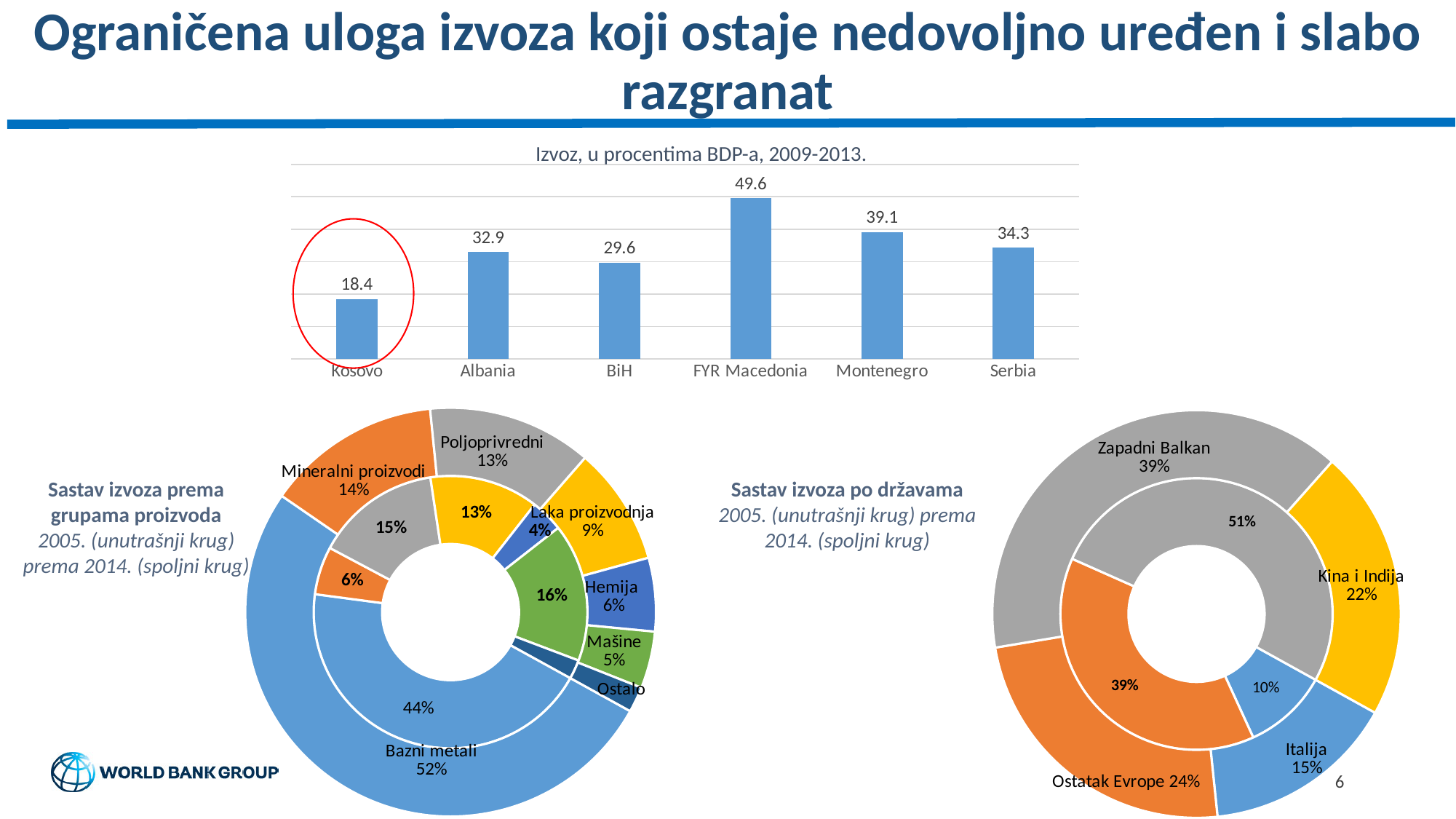
In the doughnut chart 'Sastav izvoza prema grupama proizvoda', what share does Bazni metali have in the outer (2014) ring? 52% What is the title of the bar chart at the top of the slide? Izvoz, u procentima BDP-a, 2009-2013. In the bar chart 'Izvoz, u procentima BDP-a, 2009-2013.', what is the difference between the values for FYR Macedonia and Kosovo? 31.2 In the bar chart 'Izvoz, u procentima BDP-a, 2009-2013.', which country has the lowest value? Kosovo What kind of chart is the top chart 'Izvoz, u procentima BDP-a, 2009-2013.'? bar chart In the doughnut chart 'Sastav izvoza prema grupama proizvoda', what share does Mineralni proizvodi have in the outer (2014) ring? 14% In the bar chart 'Izvoz, u procentima BDP-a, 2009-2013.', how many countries are shown? 6 In the doughnut chart 'Sastav izvoza po državama', what share does Zapadni Balkan have in the outer (2014) ring? 39% In the bar chart 'Izvoz, u procentima BDP-a, 2009-2013.', which is larger, the value for Montenegro or for Serbia? Montenegro In the bar chart 'Izvoz, u procentima BDP-a, 2009-2013.', which country has the highest value? FYR Macedonia In the bar chart 'Izvoz, u procentima BDP-a, 2009-2013.', what is the value for Kosovo? 18.4